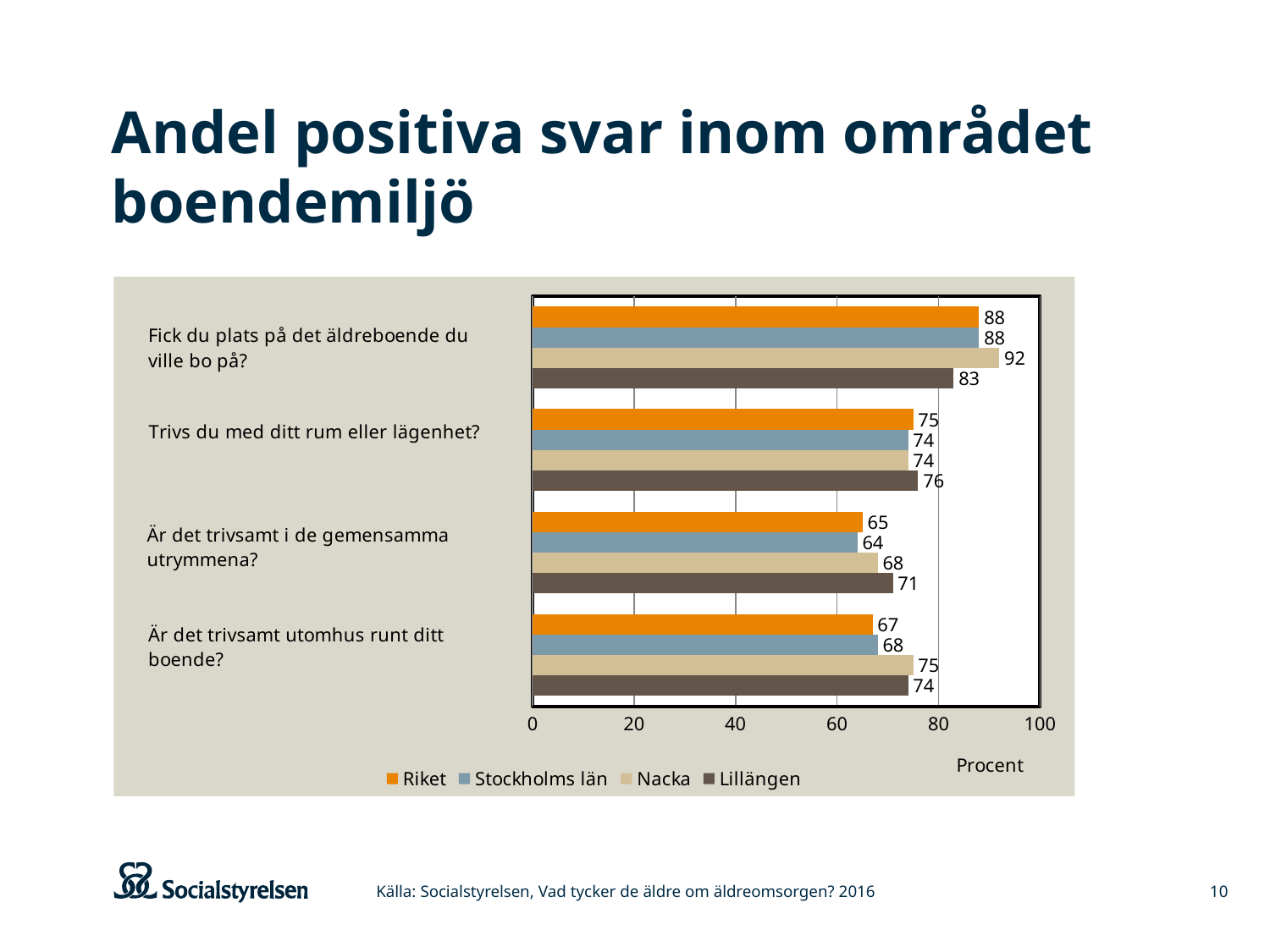
Which series has the lowest value on "Är det trivsamt i de gemensamma utrymmena?" Stockholms län What is the difference between Nacka and Riket on "Är det trivsamt utomhus runt ditt boende?" 8 Which is larger on "Är det trivsamt i de gemensamma utrymmena?": Lillängen or Riket? Lillängen What is the value for Riket on "Är det trivsamt utomhus runt ditt boende?" 67 Which series has the highest value on "Fick du plats på det äldreboende du ville bo på?" Nacka What is the value for Nacka on "Fick du plats på det äldreboende du ville bo på?" 92 What is the value for Stockholms län on "Trivs du med ditt rum eller lägenhet?" 74 How many series does the legend list? 4 What is the difference between Nacka and Lillängen on "Fick du plats på det äldreboende du ville bo på?" 9 What is the value for Lillängen on "Är det trivsamt i de gemensamma utrymmena?" 71 How many question categories are shown on the chart? 4 What kind of chart is shown on the slide? Bar chart